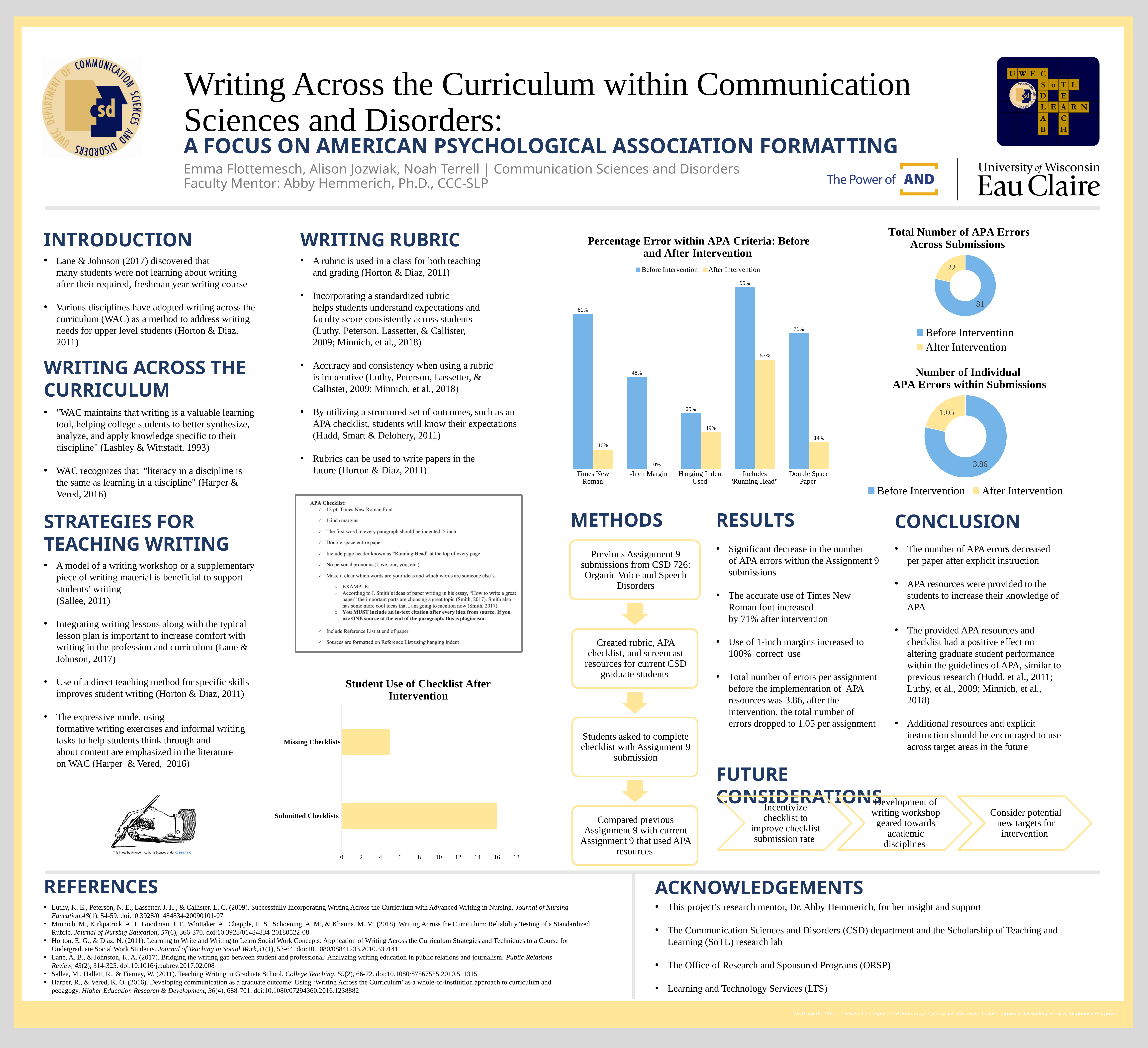
In the 'Student Use of Checklist After Intervention' chart, is the value for Missing Checklists greater or less than 10? less What kind of chart is 'Student Use of Checklist After Intervention'? Bar chart In the 'Total Number of APA Errors Across Submissions' chart, what is the value for Before Intervention? 81 In the 'Total Number of APA Errors Across Submissions' chart, what is the difference between the Before Intervention and After Intervention values? 59 In the 'Percentage Error within APA Criteria' chart, which category has the lowest After Intervention value? 1-Inch Margin In the 'Percentage Error within APA Criteria' chart, which category has the highest Before Intervention value? Includes "Running Head" In the 'Percentage Error within APA Criteria' chart, what is the After Intervention value for 1-Inch Margin? 0% In the 'Percentage Error within APA Criteria' chart, how many categories are shown on the x axis? 5 In the 'Number of Individual APA Errors within Submissions' chart, what is the value for After Intervention? 1.05 In the 'Percentage Error within APA Criteria' chart, what is the difference between the Before and After Intervention values for Double Space Paper? 57% In the 'Percentage Error within APA Criteria' chart, how many series does the legend list? 2 In the 'Percentage Error within APA Criteria' chart, what is the Before Intervention value for Times New Roman? 81%